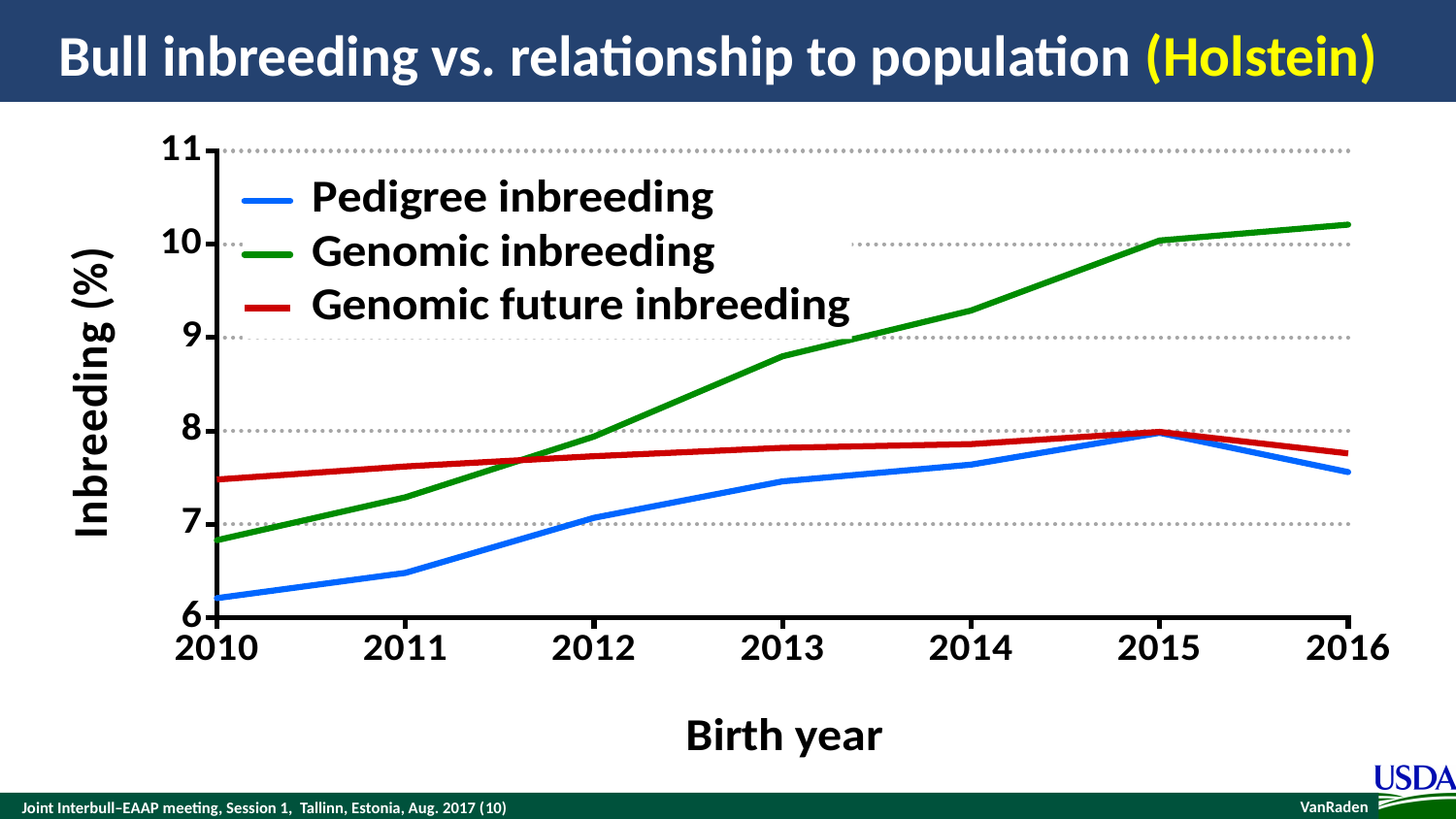
Which series has the lowest value in 2010? Pedigree inbreeding In 2016, which is higher: Genomic inbreeding or Pedigree inbreeding? Genomic inbreeding In 2010, which is higher: Genomic future inbreeding or Pedigree inbreeding? Genomic future inbreeding Does Genomic inbreeding rise or fall from 2010 to 2016? rise What kind of chart is shown on the slide? line chart Is the value for Genomic inbreeding in 2016 greater or less than 10? greater How many series does the legend list? 3 In which birth year does Pedigree inbreeding reach its highest value? 2015 How many birth years are shown on the x axis? 7 Is the value for Pedigree inbreeding in 2010 greater or less than 7? less What is the title of the x axis? Birth year Is the value for Genomic inbreeding in 2013 greater or less than 8? greater